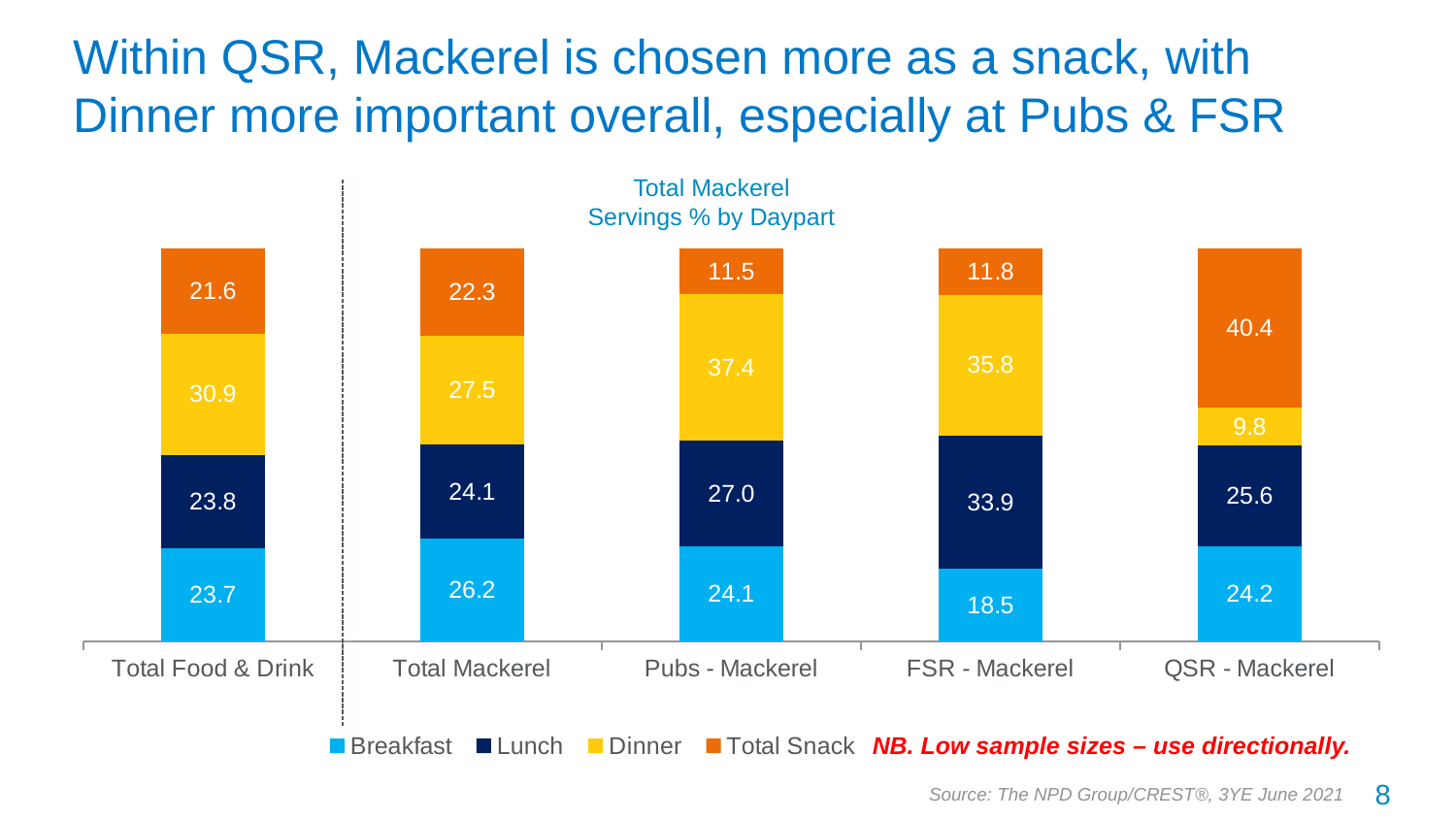
What is the Total Snack value for QSR - Mackerel? 40.4 What kind of chart is shown on the slide? Stacked bar chart What is the difference between the Total Snack value for QSR - Mackerel and the Total Snack value for Pubs - Mackerel? 28.9 What is the total of the stacked bar for Pubs - Mackerel? 100.0 What is the difference between the Lunch value for FSR - Mackerel and the Lunch value for Total Mackerel? 9.8 What is the Breakfast value for FSR - Mackerel? 18.5 How many categories are shown on the x axis? 5 Which category has the highest Total Snack value? QSR - Mackerel How many series does the legend list? 4 What is the Dinner value for Pubs - Mackerel? 37.4 Which category has the lowest Dinner value? QSR - Mackerel Which has the larger Dinner value, Pubs - Mackerel or FSR - Mackerel? Pubs - Mackerel